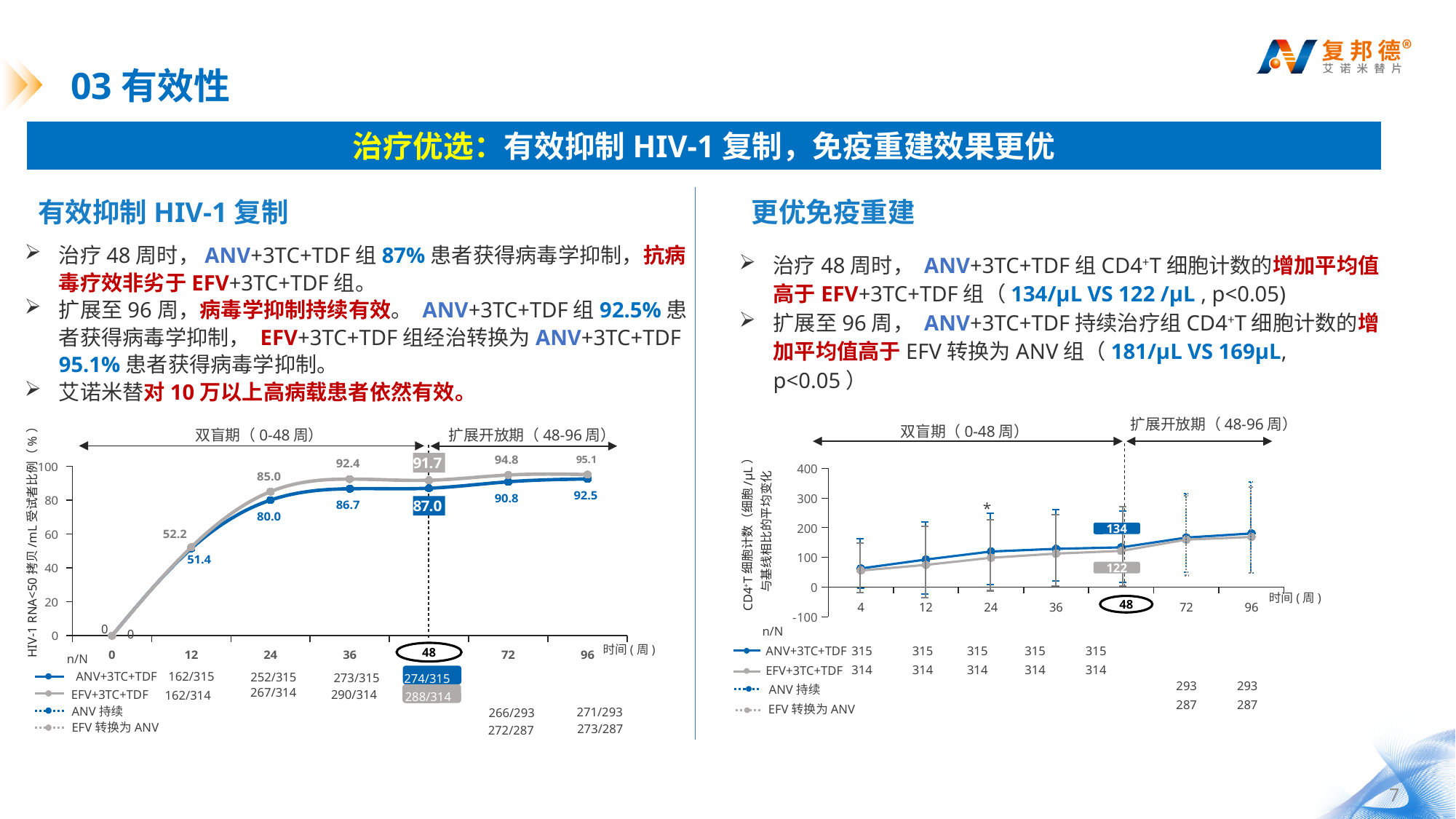
In the left chart, what is the difference between the EFV+3TC+TDF and ANV+3TC+TDF values at week 24? 5.0 In the right chart, what is the labelled value for EFV+3TC+TDF at week 48? 122 In the left chart, what is the value for ANV+3TC+TDF at week 48? 87.0 In the left chart, how many time points are plotted on the x axis? 7 In the left chart, what is the value for ANV+3TC+TDF at week 96? 92.5 In the left chart, what is the value for EFV+3TC+TDF at week 36? 92.4 In the right chart, what is the difference between the ANV+3TC+TDF and EFV+3TC+TDF values at week 48? 12 In the left chart, which series has the higher value at week 12? EFV+3TC+TDF In the left chart, at which week does the ANV+3TC+TDF series reach its highest value? 96 What kind of chart is the left chart? Line chart In the right chart, is the ANV+3TC+TDF value at week 4 greater or less than 100? less In the right chart, what is the labelled value for ANV+3TC+TDF at week 48? 134